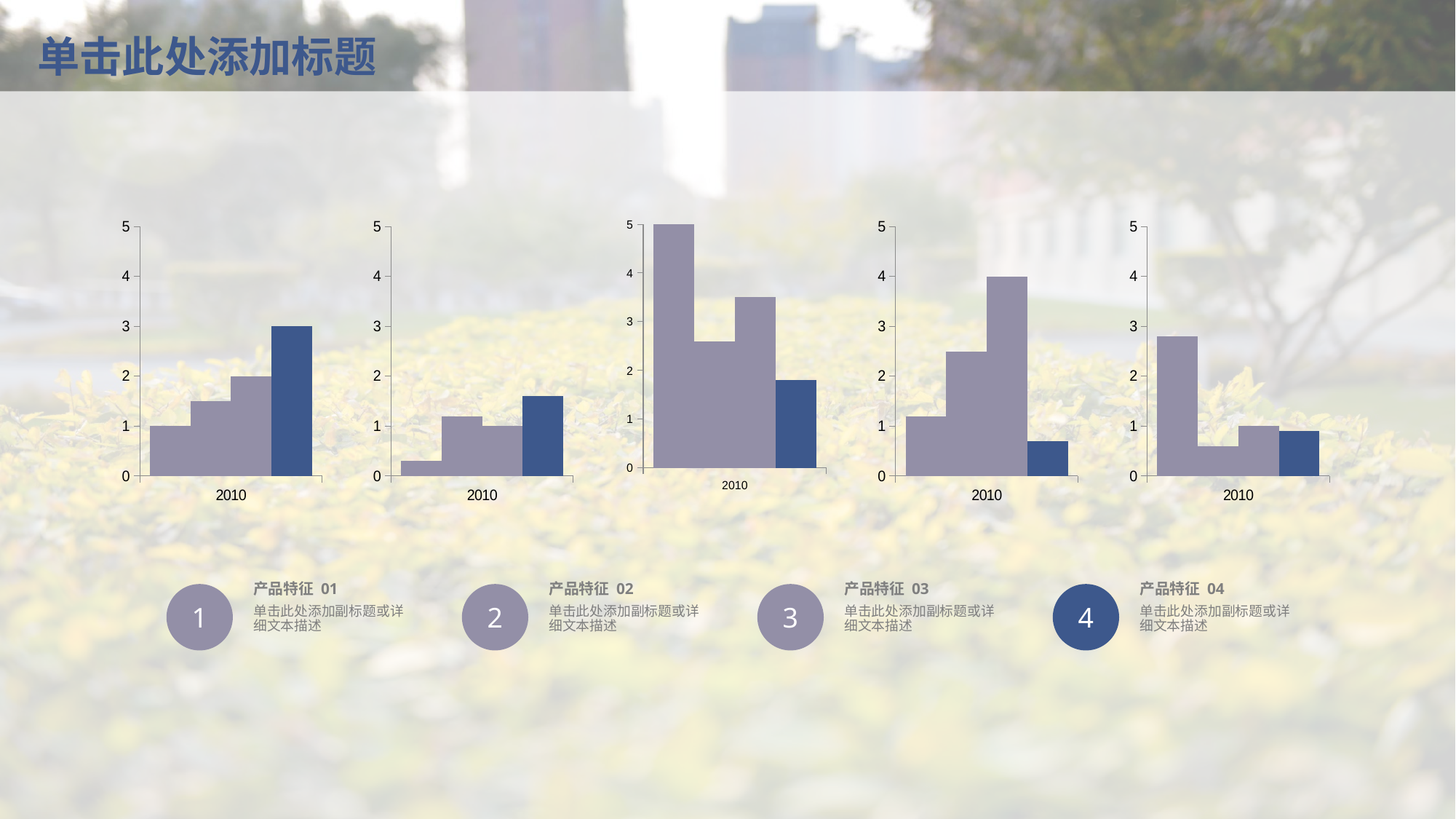
In the second chart from the left, is the value of the dark blue bar greater or less than 1? greater In the fourth chart from the left, which bar is the lowest: the first bar or the dark blue bar? the dark blue bar In the middle chart, is the value of the dark blue bar greater or less than 2? less In the rightmost chart, is the value of the first (leftmost) bar greater or less than 2? greater In the middle chart, what is the value of the tallest bar? 5 What kind of chart is the leftmost chart on the slide? bar chart In the fourth chart from the left, what is the value of the tallest bar? 4 In the leftmost chart, what is the value of the tallest (dark blue) bar? 3 What is the maximum value shown on the y axis of each chart? 5 In the leftmost chart, how many bars are plotted? 4 How many bar charts are shown on the slide? 5 In the middle chart, what is the x-axis category label? 2010